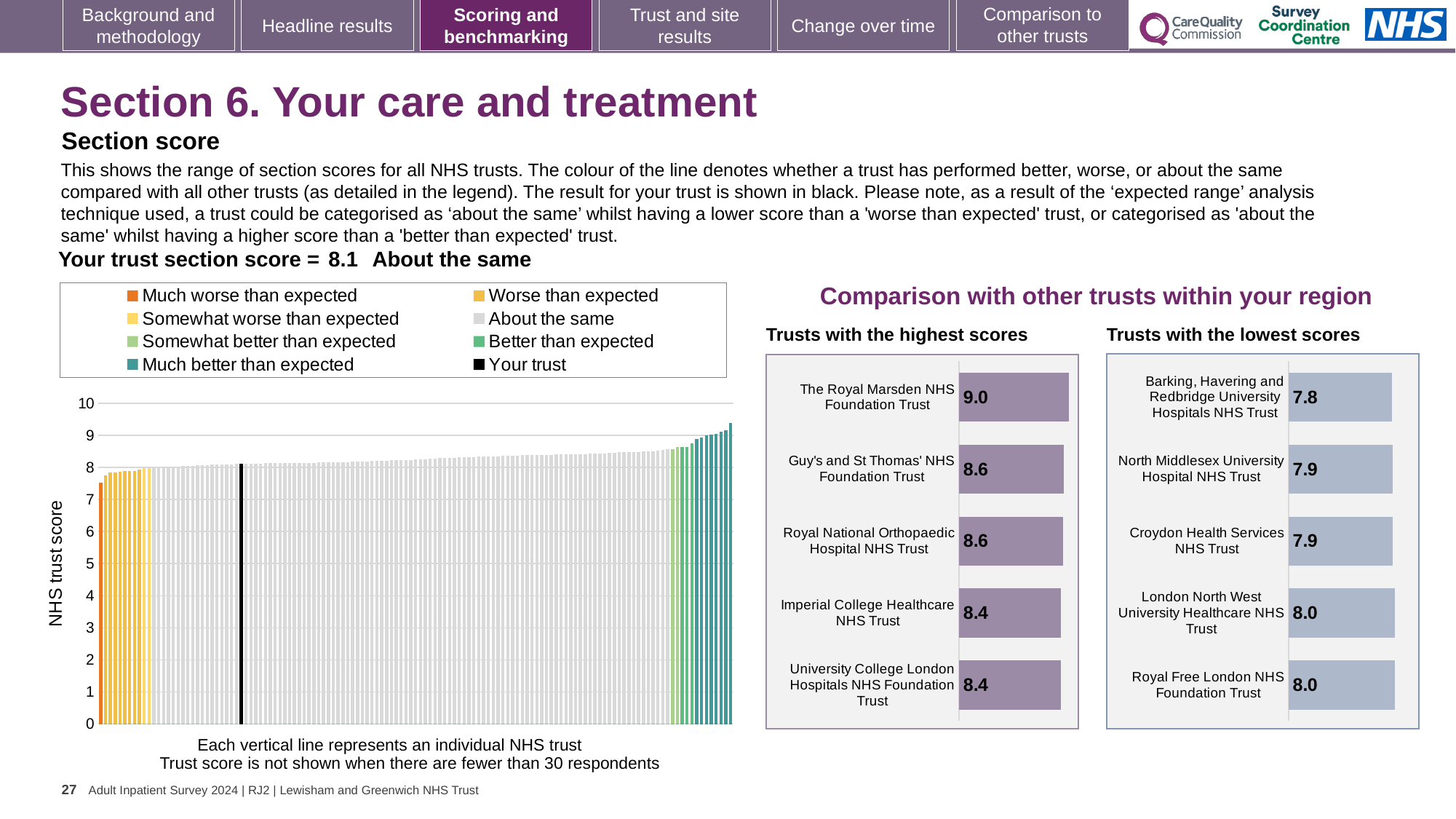
In the 'Trusts with the highest scores' chart, how many trusts are shown? 5 In the 'Trusts with the highest scores' chart, which trust has the highest score? The Royal Marsden NHS Foundation Trust In the large chart on the left, is the value for the black 'Your trust' bar greater or less than 9? less In the 'Trusts with the highest scores' chart, what is the difference between the scores of The Royal Marsden NHS Foundation Trust and Imperial College Healthcare NHS Trust? 0.6 In the 'Trusts with the highest scores' chart, what is the score for The Royal Marsden NHS Foundation Trust? 9.0 In the 'Trusts with the lowest scores' chart, what is the difference between the scores of Royal Free London NHS Foundation Trust and Barking, Havering and Redbridge University Hospitals NHS Trust? 0.2 In the 'Trusts with the lowest scores' chart, which trust has the lowest score? Barking, Havering and Redbridge University Hospitals NHS Trust What kind of chart is the large chart on the left showing NHS trust scores? Bar chart In the 'Trusts with the lowest scores' chart, what is the score for Croydon Health Services NHS Trust? 7.9 In the large chart on the left, do the trust scores rise or fall from left to right along the x axis? Rise In the 'Trusts with the highest scores' chart, which has the larger score: Guy's and St Thomas' NHS Foundation Trust or Imperial College Healthcare NHS Trust? Guy's and St Thomas' NHS Foundation Trust How many entries does the legend of the large chart on the left list? 8